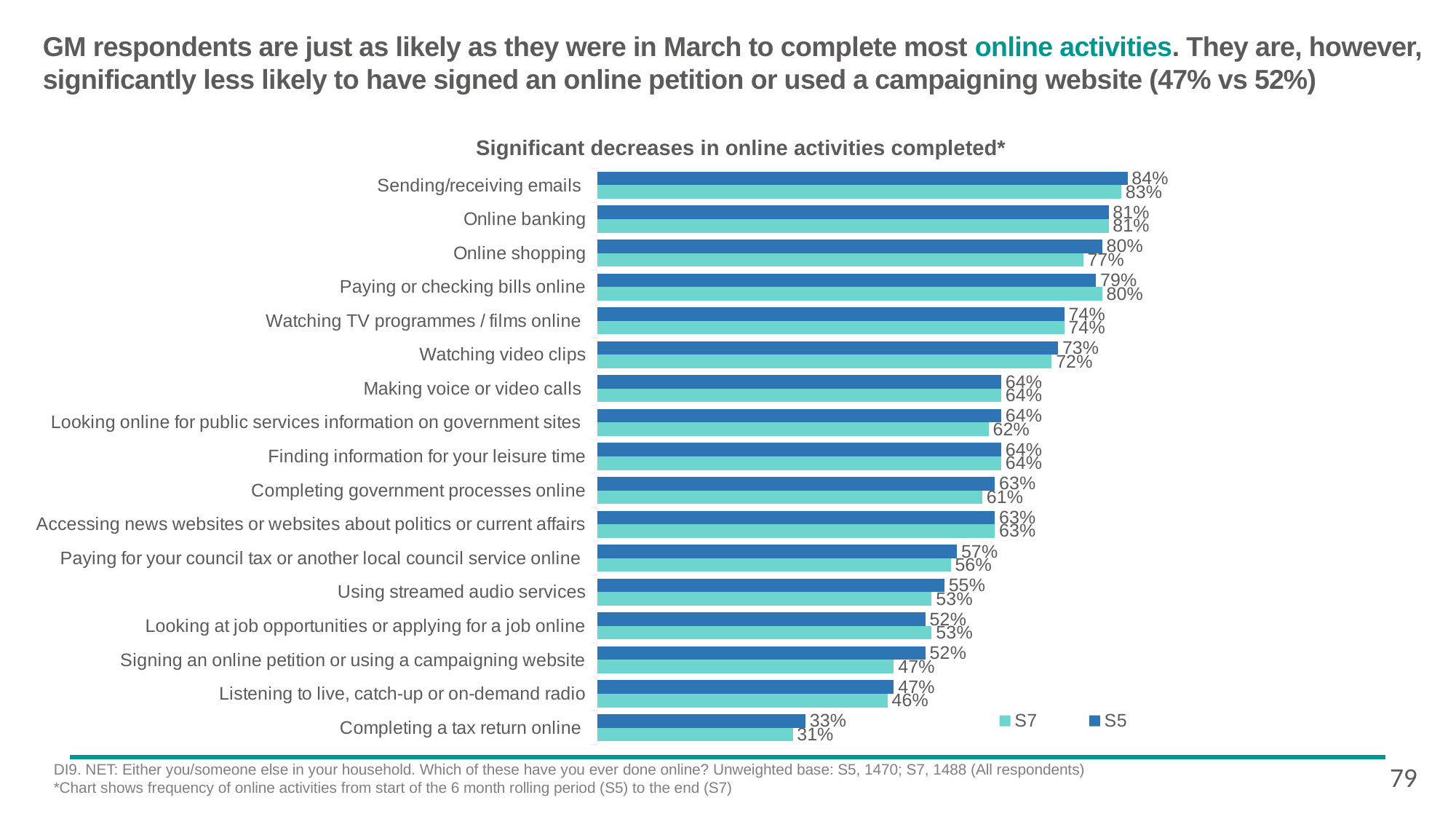
What is the S5 value for Sending/receiving emails? 84% What is the title of the chart? Significant decreases in online activities completed* What kind of chart is shown on the slide? Bar chart Which activity has the highest S5 value? Sending/receiving emails What is the S7 value for Online shopping? 77% Which activity has the lowest S7 value? Completing a tax return online What is the difference between the S5 and S7 values for Completing a tax return online? 2 percentage points How many activities are listed in the chart? 17 How many series does the legend list? 2 Which is larger for Paying or checking bills online, the S5 value or the S7 value? S7 What is the difference between the S5 and S7 values for Signing an online petition or using a campaigning website? 5 percentage points What is the S7 value for Signing an online petition or using a campaigning website? 47%